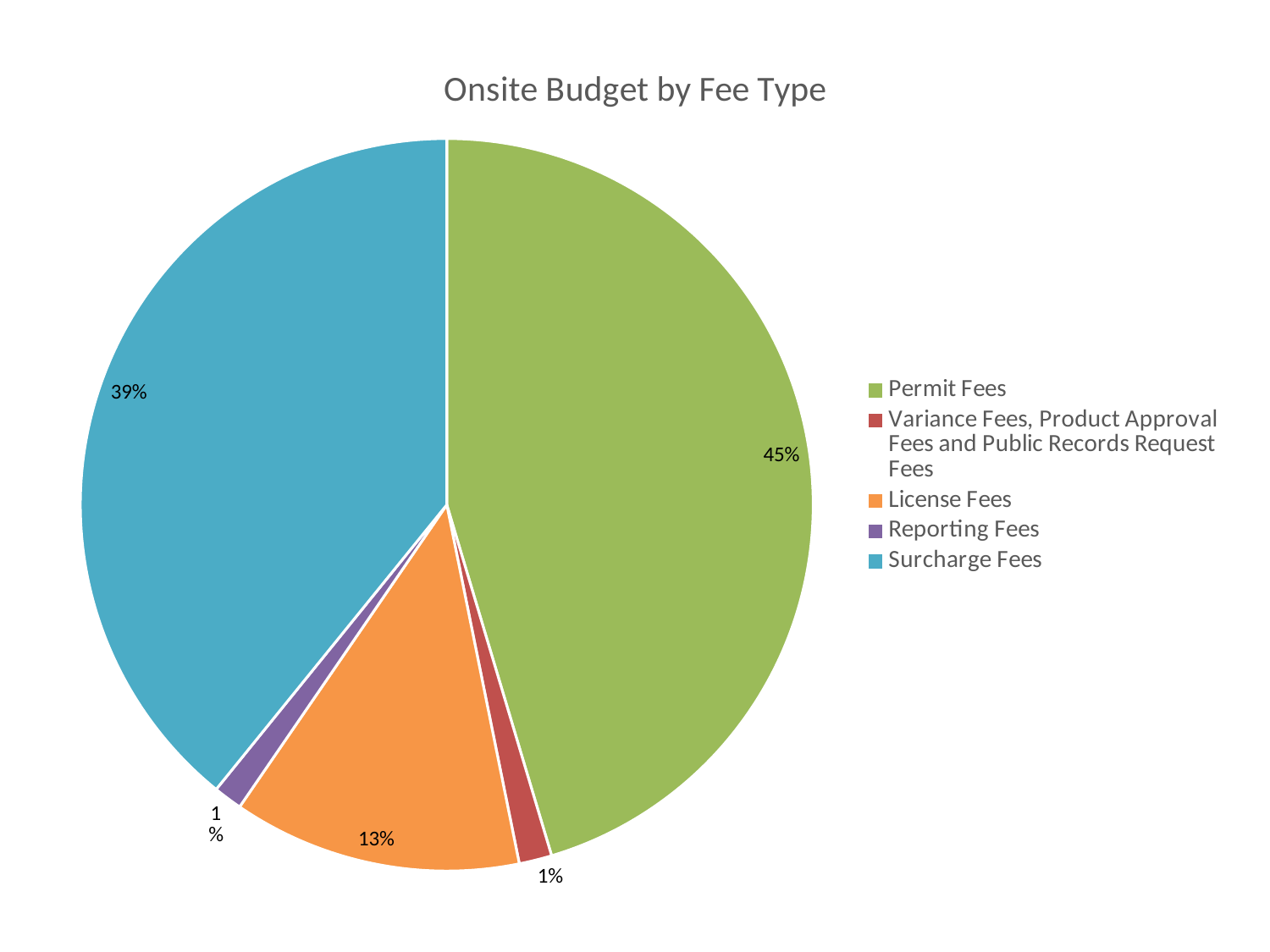
Which is larger, the share for License Fees or the share for Surcharge Fees? Surcharge Fees What share of the onsite budget comes from Reporting Fees? 1% What is the difference in percentage points between the Permit Fees share and the Surcharge Fees share? 6 percentage points What is the difference in percentage points between the Surcharge Fees share and the License Fees share? 26 percentage points What share of the onsite budget comes from License Fees? 13% What is the title of the chart? Onsite Budget by Fee Type Which fee type accounts for the largest share of the onsite budget? Permit Fees What colour is the Surcharge Fees slice? blue What share of the onsite budget comes from Permit Fees? 45% What kind of chart is shown on the slide? pie chart How many fee types does the legend list? 5